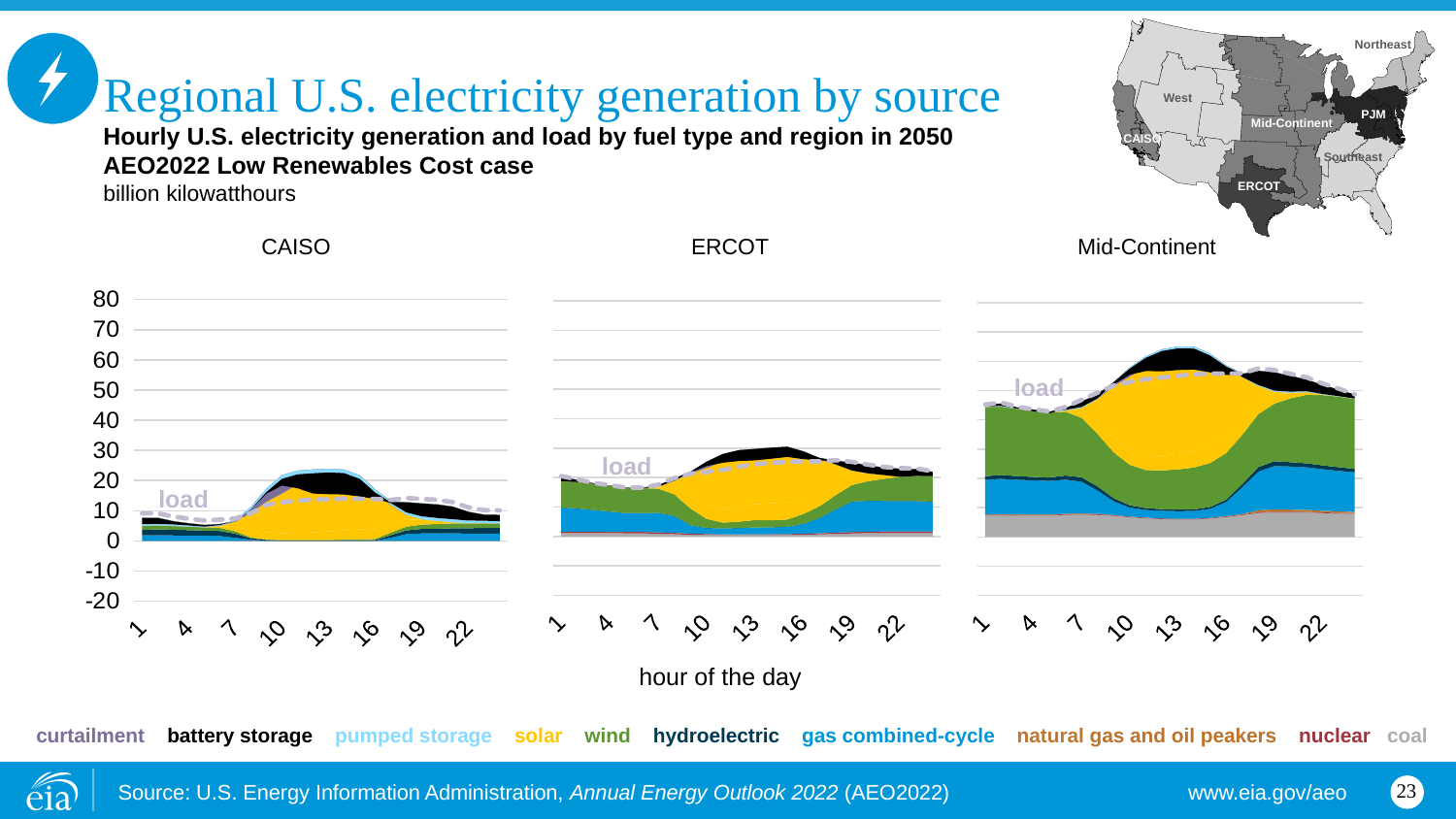
What is the label of the shared x axis beneath the three charts? hour of the day Which of the three regions shows the highest peak hourly generation? Mid-Continent In the CAISO chart, does total generation rise or fall between hour 7 and hour 13? rise What kind of chart is used for the CAISO, ERCOT and Mid-Continent panels on this slide? stacked area chart In the ERCOT chart, is the peak total generation around hour 13 greater or less than 40? less In the CAISO chart, is the total generation around hour 13 greater or less than 10? greater How many fuel-type series does the legend at the bottom of the slide list? 10 How many regional charts are shown on the slide? 3 In the CAISO chart, is the peak total generation around hour 13 greater or less than 30? less Which of the three regions shows the lowest peak hourly generation? CAISO